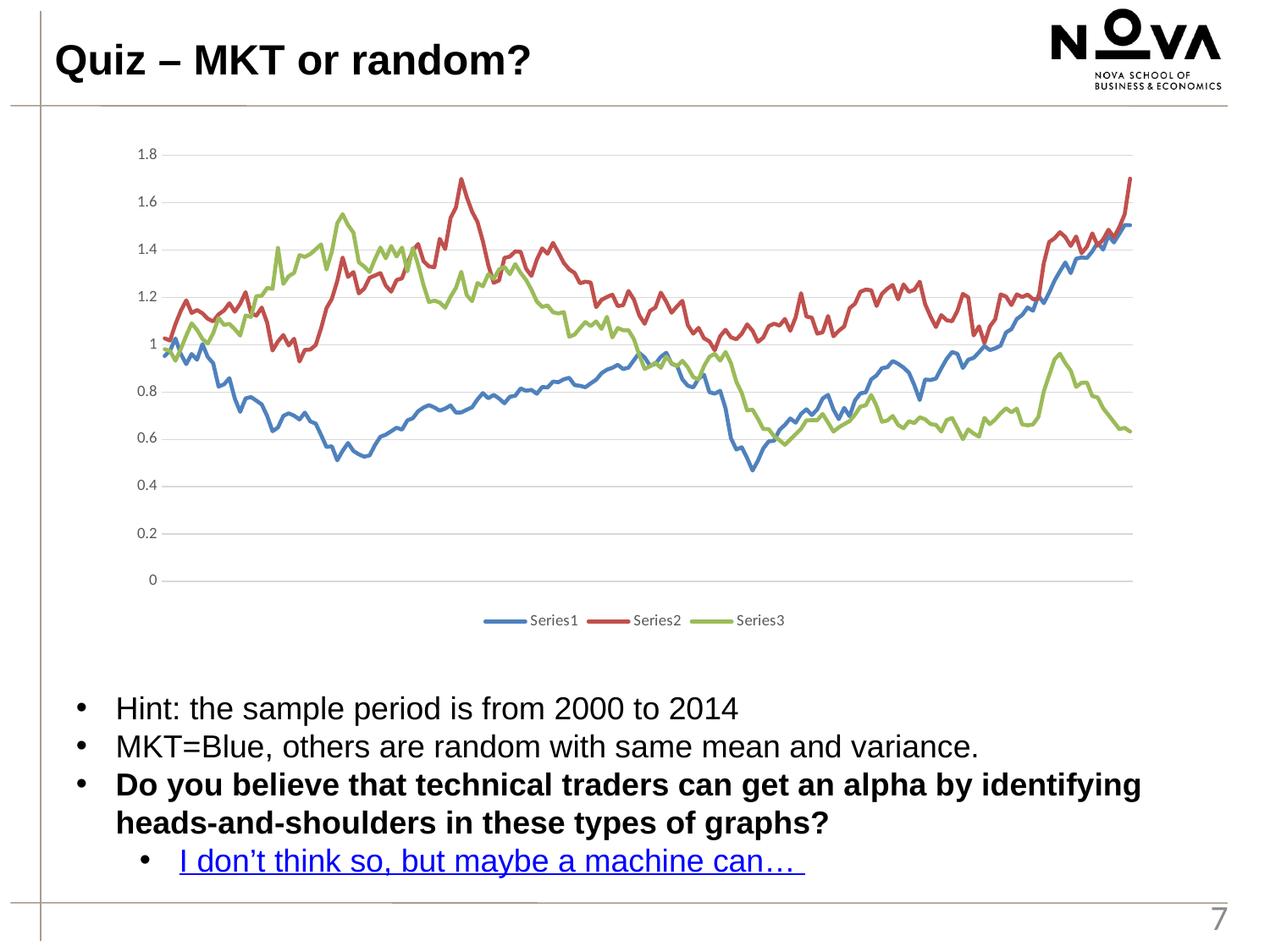
Is the final value of Series3 at the right end of the chart greater or less than 0.8? less At the right end of the chart, which is higher, Series2 or Series3? Series2 What kind of chart is shown on the slide? line chart Is the lowest value reached by Series1 greater or less than 0.6? less Is the highest value reached by Series2 greater or less than 1.6? greater How many series does the legend list? 3 Which series reaches the highest value anywhere on the chart? Series2 Which series ends lowest at the right end of the chart? Series3 Which series reaches the lowest value anywhere on the chart? Series1 What are the names of the series in the legend? Series1, Series2, Series3 What colour is the line for Series1? blue Overall, does Series3 rise or fall from the left end of the chart to the right end? fall